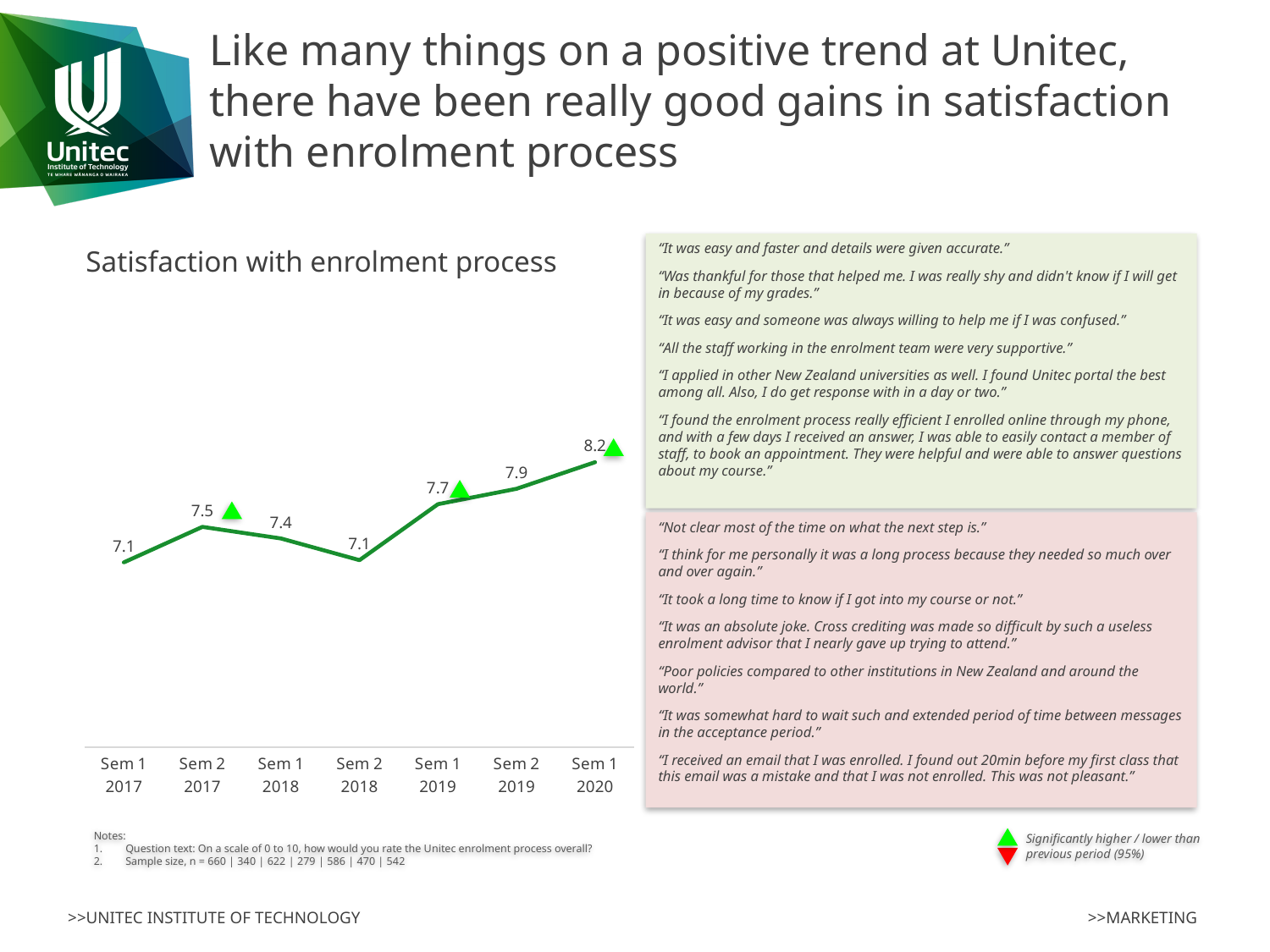
Does the satisfaction with enrolment process score rise or fall from Sem 2 2018 to Sem 1 2020? Rise What is the satisfaction with enrolment process score for Sem 1 2020? 8.2 What is the title of the chart on the slide? Satisfaction with enrolment process What is the difference between the satisfaction scores for Sem 1 2020 and Sem 1 2017? 1.1 What is the difference between the satisfaction scores for Sem 2 2019 and Sem 1 2019? 0.2 Which is higher, the satisfaction score for Sem 1 2018 or Sem 2 2018? Sem 1 2018 Which period has the highest satisfaction with enrolment process score? Sem 1 2020 What is the lowest satisfaction with enrolment process score shown on the chart? 7.1 What type of chart is used to show satisfaction with enrolment process? Line chart What is the satisfaction with enrolment process score for Sem 2 2017? 7.5 How many periods are plotted on the satisfaction with enrolment process chart? 7 What is the satisfaction with enrolment process score for Sem 2 2018? 7.1